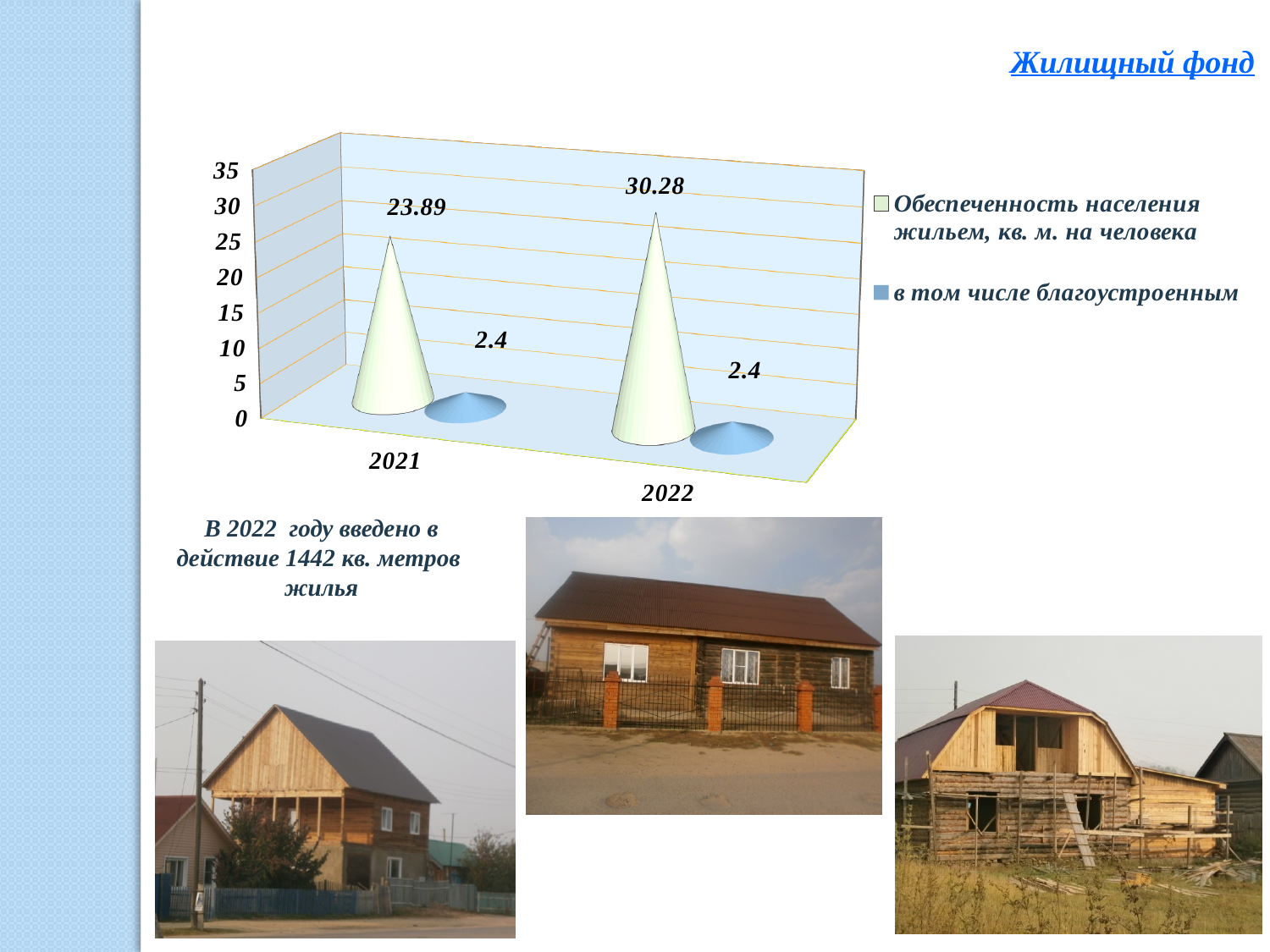
Which is larger in 2022: 'Обеспеченность населения жильем, кв. м. на человека' or 'в том числе благоустроенным'? Обеспеченность населения жильем, кв. м. на человека What is the value for 'в том числе благоустроенным' in 2022? 2.4 What is the value for 'Обеспеченность населения жильем, кв. м. на человека' in 2022? 30.28 What kind of chart is shown on the slide? bar chart In which year is 'Обеспеченность населения жильем, кв. м. на человека' highest? 2022 What is the value for 'Обеспеченность населения жильем, кв. м. на человека' in 2021? 23.89 How many series does the chart legend list? 2 What is the value for 'в том числе благоустроенным' in 2021? 2.4 Is the value for 'Обеспеченность населения жильем, кв. м. на человека' in 2022 greater or less than 30? greater How many years are shown on the x axis of the chart? 2 By how much did 'Обеспеченность населения жильем, кв. м. на человека' change from 2021 to 2022? 6.39 Does 'Обеспеченность населения жильем, кв. м. на человека' rise or fall from 2021 to 2022? rise